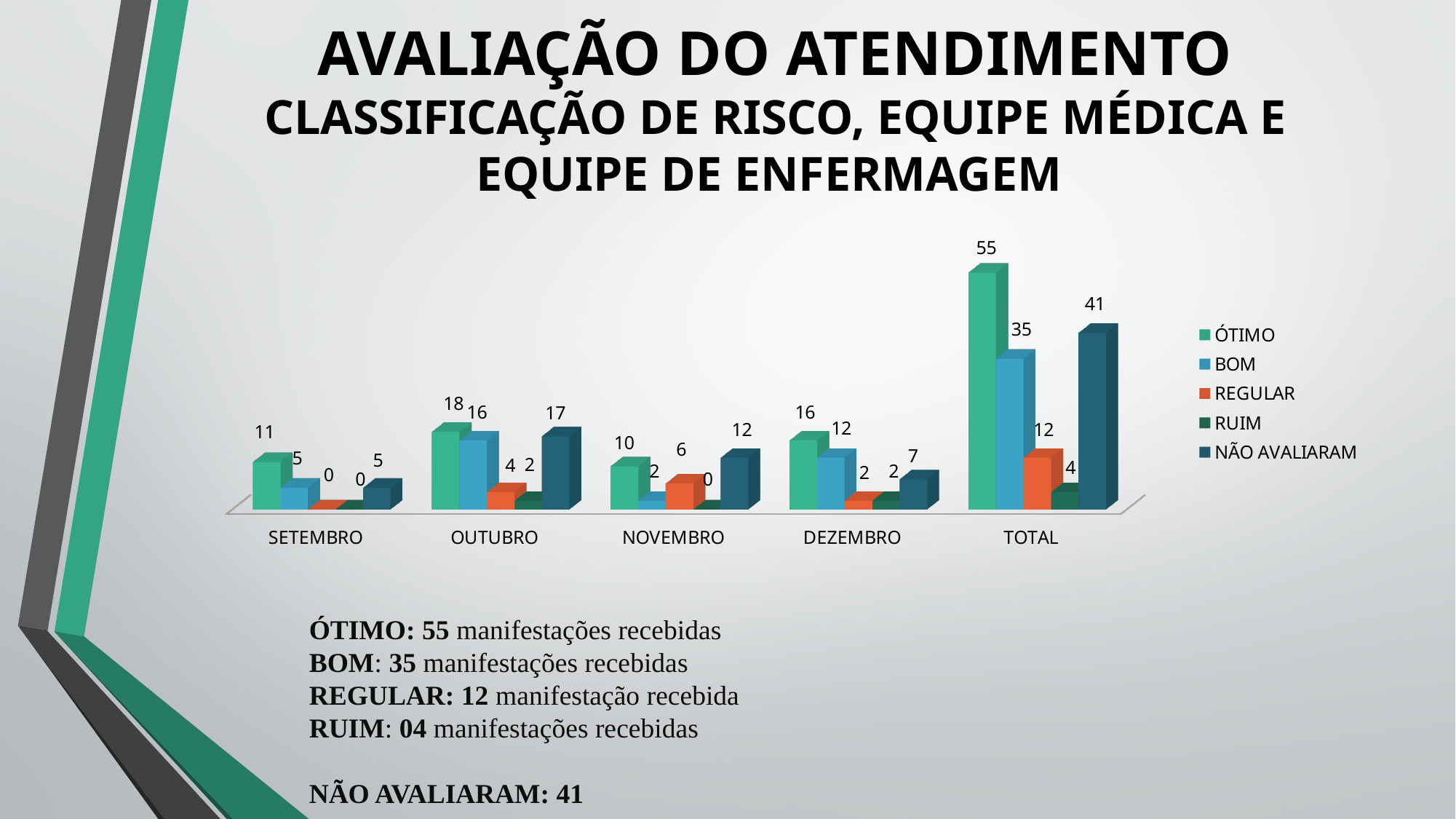
What is the value for ÓTIMO in OUTUBRO? 18 What kind of chart is shown on the slide? Bar chart How many series does the legend list? 5 Which series has the lowest value in the TOTAL category? RUIM What is the difference between ÓTIMO and BOM in DEZEMBRO? 4 Which is larger in NOVEMBRO, REGULAR or BOM? REGULAR Which legend entry is shown in orange? REGULAR What is the value for BOM in TOTAL? 35 What is the value for NÃO AVALIARAM in NOVEMBRO? 12 How many categories are shown on the x axis? 5 What is the value for REGULAR in SETEMBRO? 0 Which month has the highest value for ÓTIMO (excluding TOTAL)? OUTUBRO